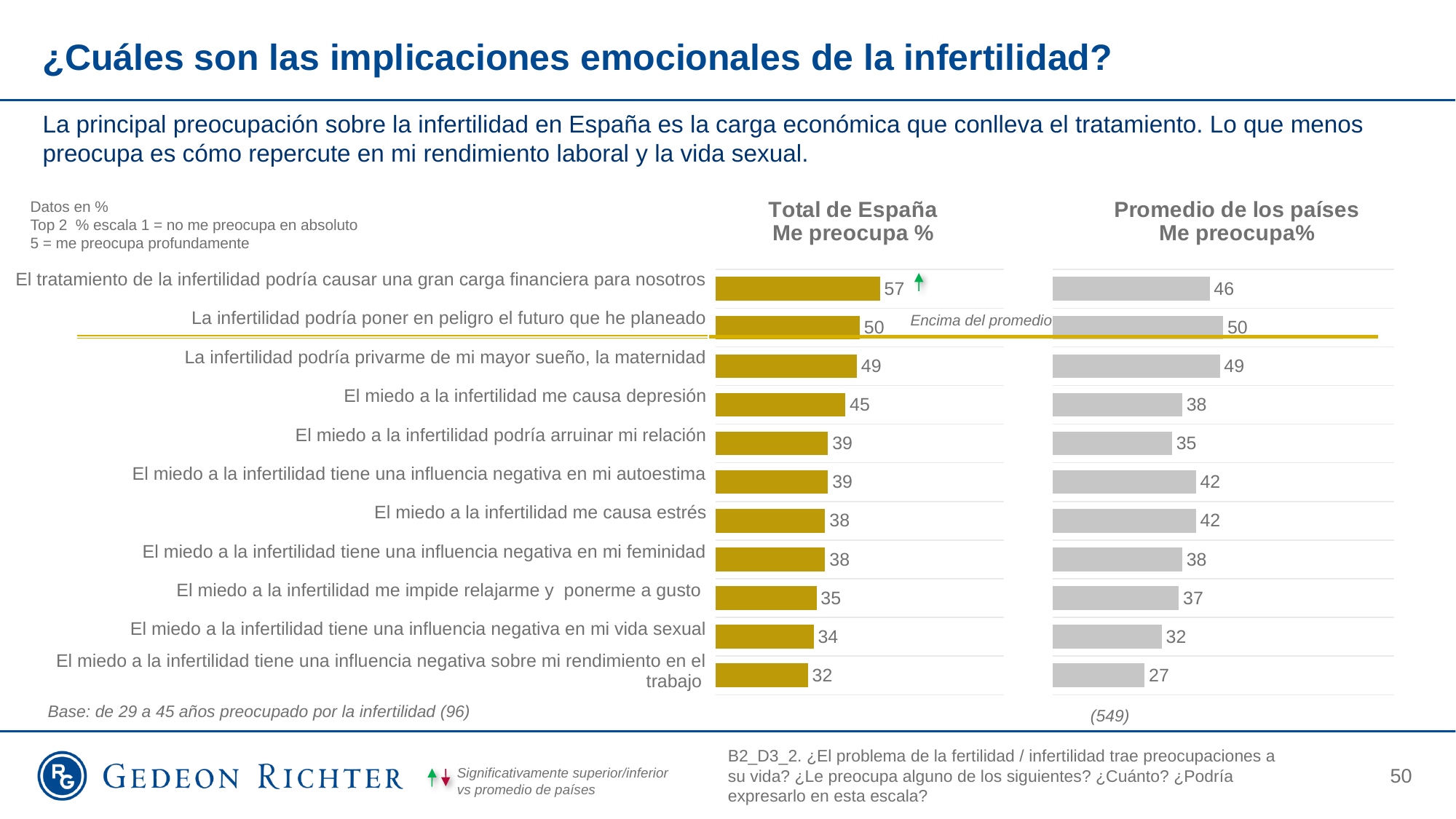
In the 'Promedio de los países Me preocupa%' chart, what is the value for 'La infertilidad podría poner en peligro el futuro que he planeado'? 50 In the 'Total de España Me preocupa %' chart, what is the value for 'El tratamiento de la infertilidad podría causar una gran carga financiera para nosotros'? 57 In the 'Total de España Me preocupa %' chart, what is the value for 'El miedo a la infertilidad tiene una influencia negativa en mi vida sexual'? 34 For 'El miedo a la infertilidad me causa estrés', which chart shows the larger value: 'Total de España Me preocupa %' or 'Promedio de los países Me preocupa%'? Promedio de los países Me preocupa% In the 'Total de España Me preocupa %' chart, what is the difference between the value for 'El tratamiento de la infertilidad podría causar una gran carga financiera para nosotros' and the value for 'El miedo a la infertilidad tiene una influencia negativa sobre mi rendimiento en el trabajo'? 25 In the 'Total de España Me preocupa %' chart, which category has the highest value? El tratamiento de la infertilidad podría causar una gran carga financiera para nosotros In the 'Promedio de los países Me preocupa%' chart, what is the difference between the value for 'El miedo a la infertilidad tiene una influencia negativa en mi autoestima' and the value for 'El miedo a la infertilidad podría arruinar mi relación'? 7 What kind of chart is the 'Total de España Me preocupa %' chart? Bar chart In the 'Promedio de los países Me preocupa%' chart, what is the value for 'El miedo a la infertilidad me causa depresión'? 38 In the 'Promedio de los países Me preocupa%' chart, which category has the lowest value? El miedo a la infertilidad tiene una influencia negativa sobre mi rendimiento en el trabajo What colour are the bars in the 'Total de España Me preocupa %' chart? Gold (yellow) How many categories are shown in the 'Total de España Me preocupa %' chart? 11